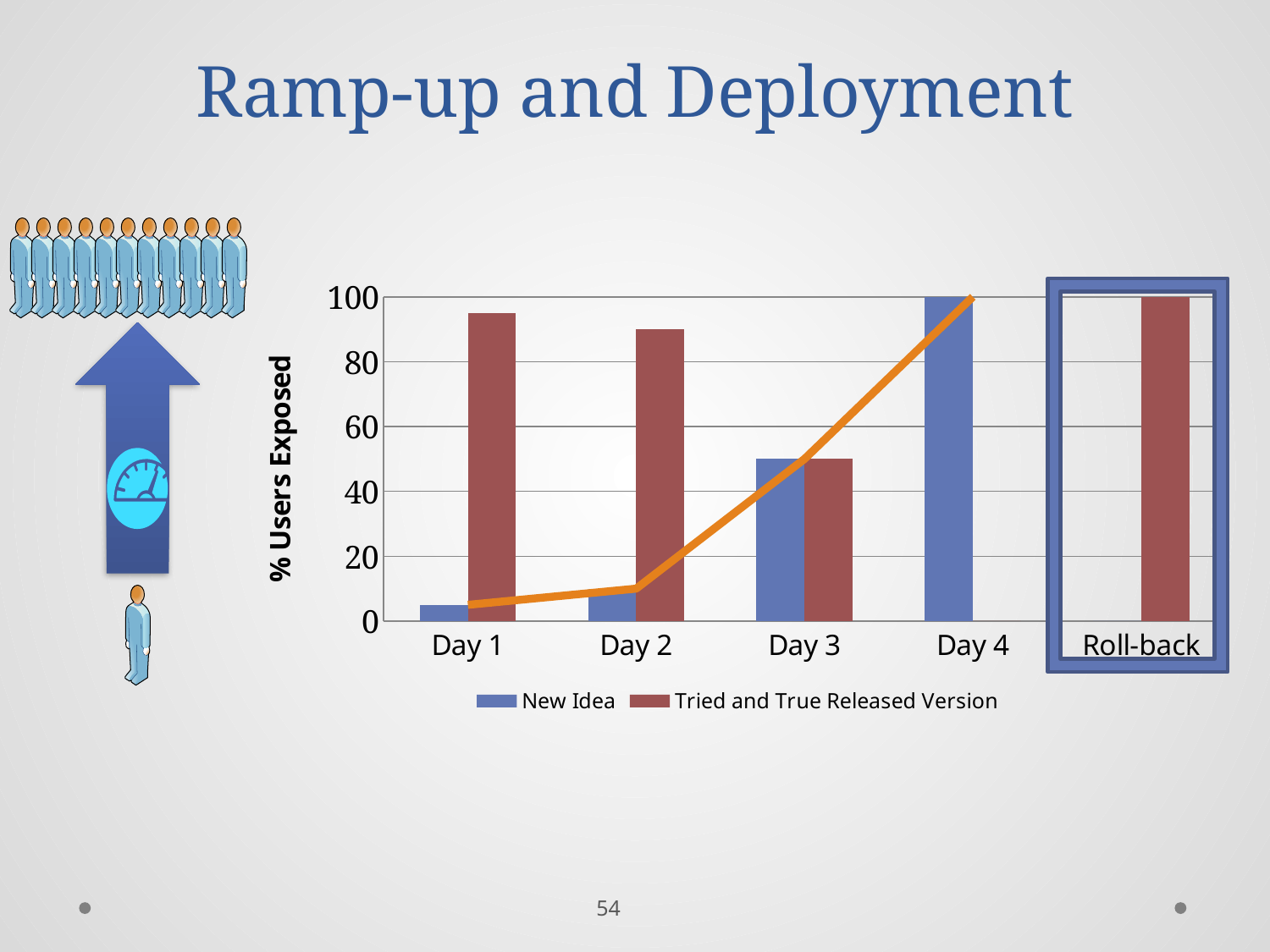
What is the value for Tried and True Released Version at Roll-back? 100 On which day is the New Idea value highest? Day 4 On Day 2, which is larger: New Idea or Tried and True Released Version? Tried and True Released Version Do the New Idea values rise or fall from Day 1 to Day 4? rise What kind of chart is shown on the slide? combination bar and line chart Is the value for Tried and True Released Version on Day 1 greater or less than 80? greater Is the value for New Idea on Day 1 greater or less than 20? less What is the value for New Idea on Day 4? 100 How many series does the legend list? 2 How many categories are shown on the x axis? 5 What is the title of the vertical axis? % Users Exposed Is the value for New Idea on Day 3 greater or less than 40? greater